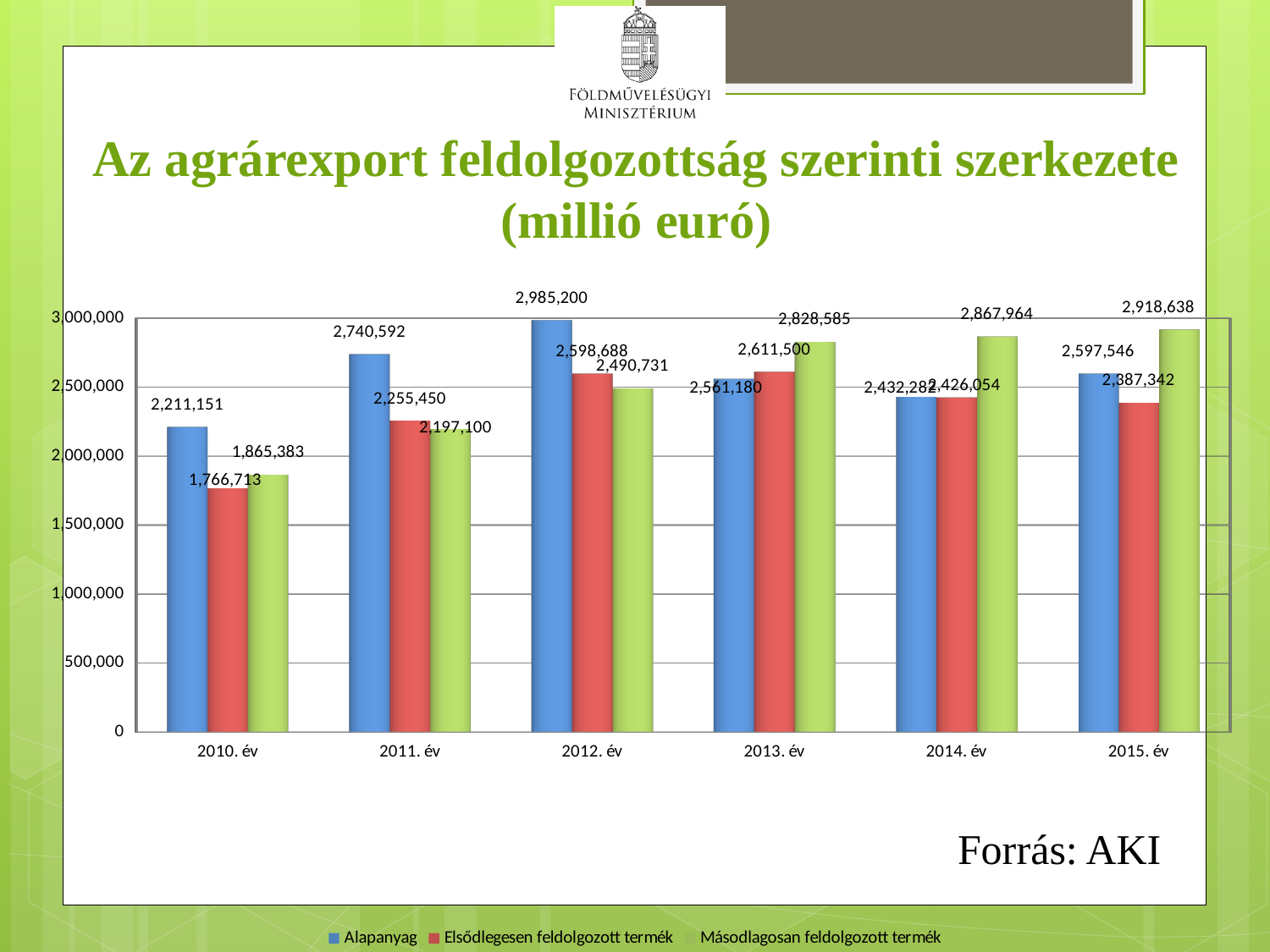
What kind of chart is shown on the slide? bar chart In which year is the Elsődlegesen feldolgozott termék value the lowest? 2010. év What is the value for Elsődlegesen feldolgozott termék in 2011. év? 2,255,450 Is the value for Alapanyag in 2011. év greater or less than 2,500,000? greater What is the difference between Másodlagosan feldolgozott termék and Elsődlegesen feldolgozott termék in 2010. év? 98,670 In 2013. év, which is larger: Alapanyag or Másodlagosan feldolgozott termék? Másodlagosan feldolgozott termék In which year is the Alapanyag value the highest? 2012. év What is the value for Másodlagosan feldolgozott termék in 2015. év? 2,918,638 How many years are shown on the x axis? 6 What is the value for Alapanyag in 2012. év? 2,985,200 How many series does the legend list? 3 Does the Másodlagosan feldolgozott termék value rise or fall from 2010. év to 2015. év? rise